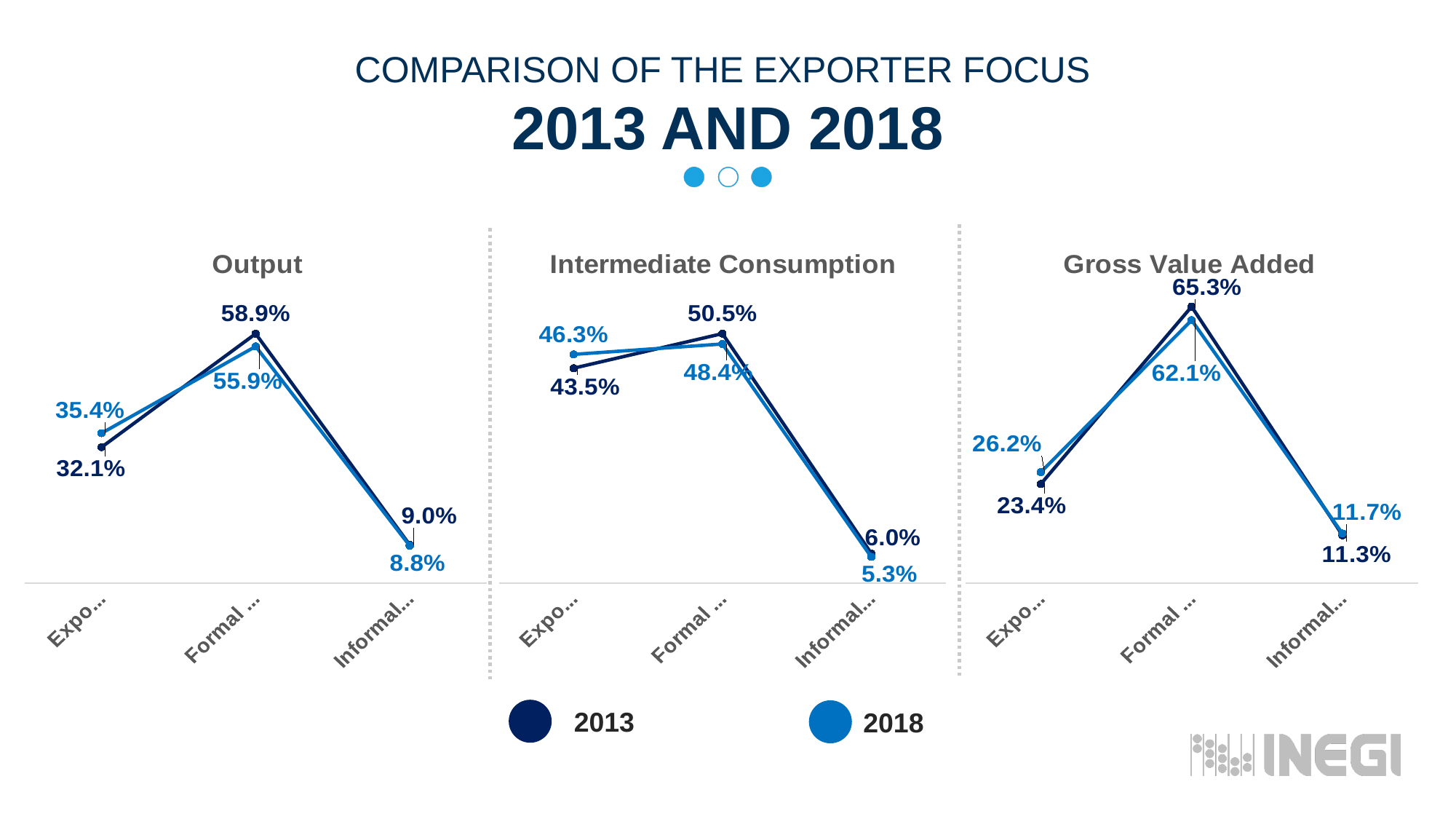
How many series does the legend list? 2 In the Gross Value Added chart, what is the 2013 value for the Informal category? 11.3% In the Output chart, what is the 2018 value for the Informal category? 8.8% In the Output chart, what is the 2013 value for the Formal category? 58.9% In the Gross Value Added chart, which category has the highest 2013 value? Formal In the Output chart, what is the difference between the 2013 and 2018 values for the Formal category? 3.0% What kind of chart is used for Output, Intermediate Consumption and Gross Value Added? Line chart In the Intermediate Consumption chart, which category has the lowest 2018 value? Informal In the Gross Value Added chart, what is the difference between the 2018 and 2013 values for the category labelled 'Expo...'? 2.8% Which colour represents the 2018 series in the legend? Light blue In the Intermediate Consumption chart, which is larger for the Formal category: the 2013 value or the 2018 value? 2013 In the Intermediate Consumption chart, what is the 2018 value for the category labelled 'Expo...'? 46.3%